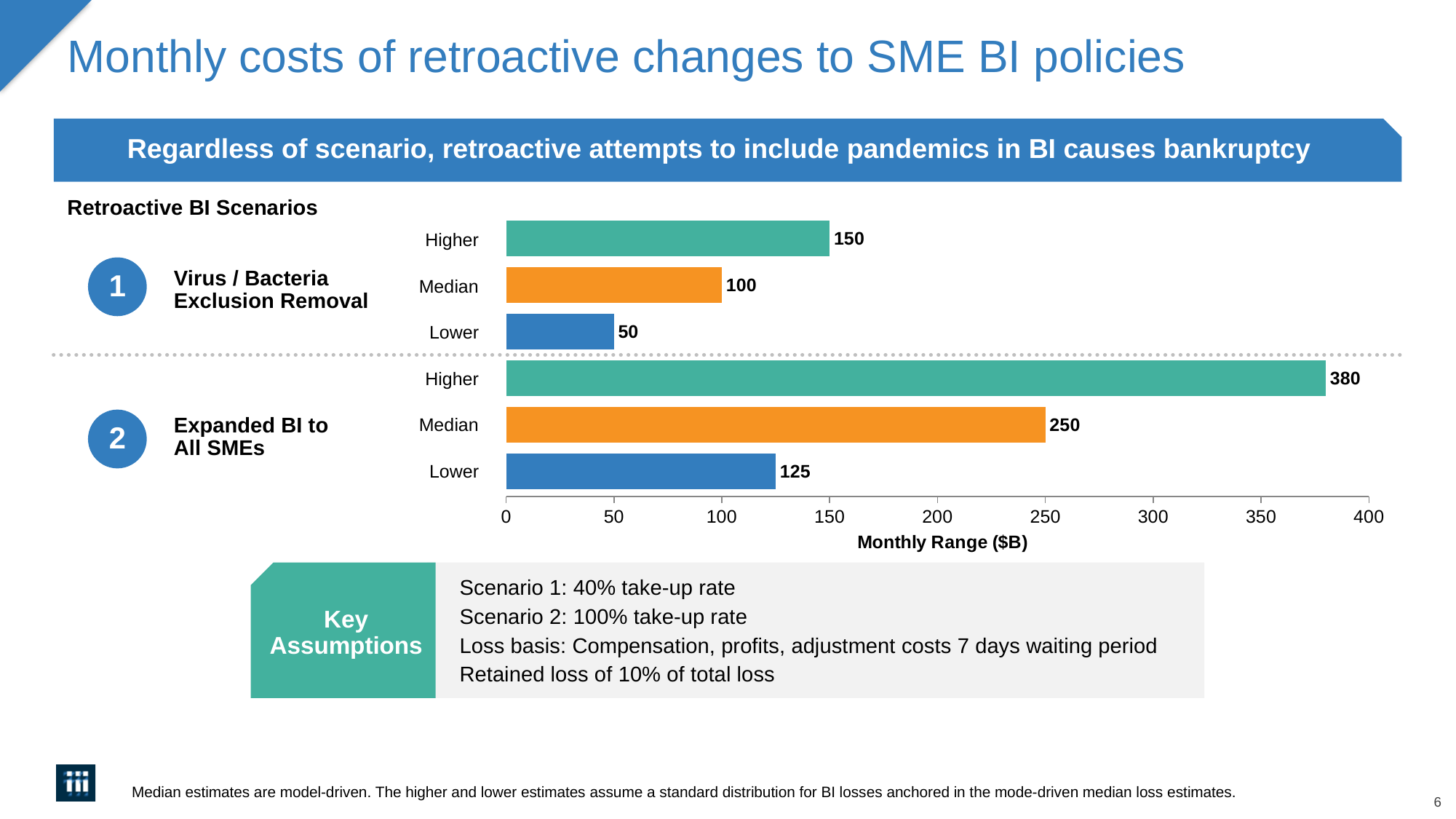
What is the Higher estimate for Scenario 1 (Virus / Bacteria Exclusion Removal)? 150 What colour are the Median bars? Orange What is the difference between the Higher estimates of Scenario 2 and Scenario 1? 230 What is the Median estimate for Scenario 2 (Expanded BI to All SMEs)? 250 Which bar has the highest value on the chart? Scenario 2 Higher (380) What is the difference between the Median and Lower estimates for Scenario 1? 50 What is the label of the horizontal axis? Monthly Range ($B) How many bars are plotted on the chart? 6 Which is larger: the Lower estimate for Scenario 2 or the Median estimate for Scenario 1? Lower estimate for Scenario 2 What kind of chart is shown on the slide? Bar chart What is the Lower estimate for Scenario 2 (Expanded BI to All SMEs)? 125 Which bar has the lowest value on the chart? Scenario 1 Lower (50)